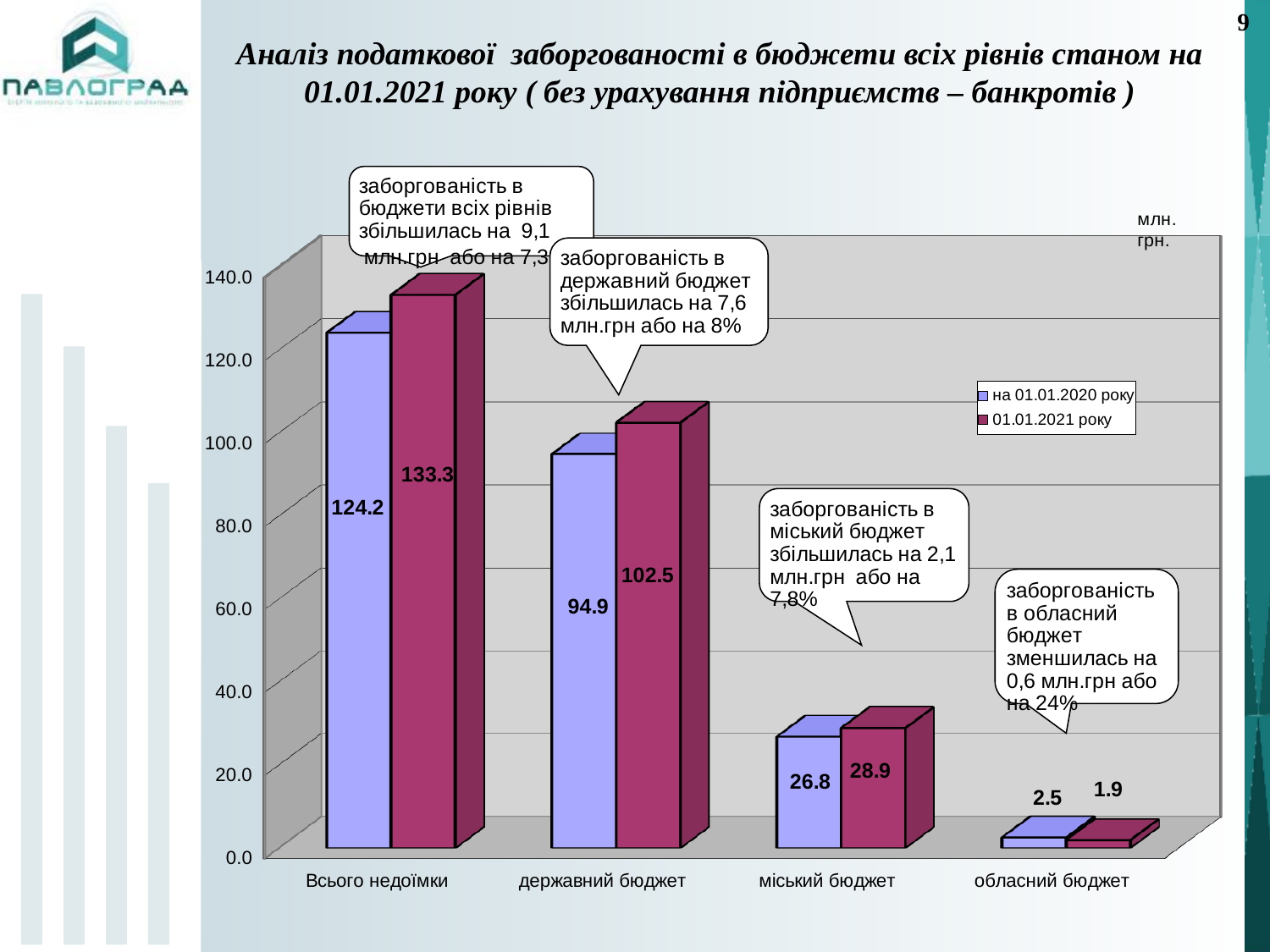
What kind of chart is shown on the slide? bar chart Is the value for "міський бюджет" in the "на 01.01.2020 року" series greater or less than 40.0? less What is the value for "Всього недоїмки" in the "01.01.2021 року" series? 133.3 For "обласний бюджет", which series has the larger value: "на 01.01.2020 року" or "01.01.2021 року"? на 01.01.2020 року Which category has the highest value in the "на 01.01.2020 року" series? Всього недоїмки How many series does the chart legend list? 2 What is the value for "державний бюджет" in the "на 01.01.2020 року" series? 94.9 What is the value for "міський бюджет" in the "01.01.2021 року" series? 28.9 What is the value for "обласний бюджет" in the "на 01.01.2020 року" series? 2.5 Which category has the lowest value in the "01.01.2021 року" series? обласний бюджет What is the difference between the "01.01.2021 року" and "на 01.01.2020 року" values for "державний бюджет"? 7.6 How many categories are shown on the x axis of the chart? 4